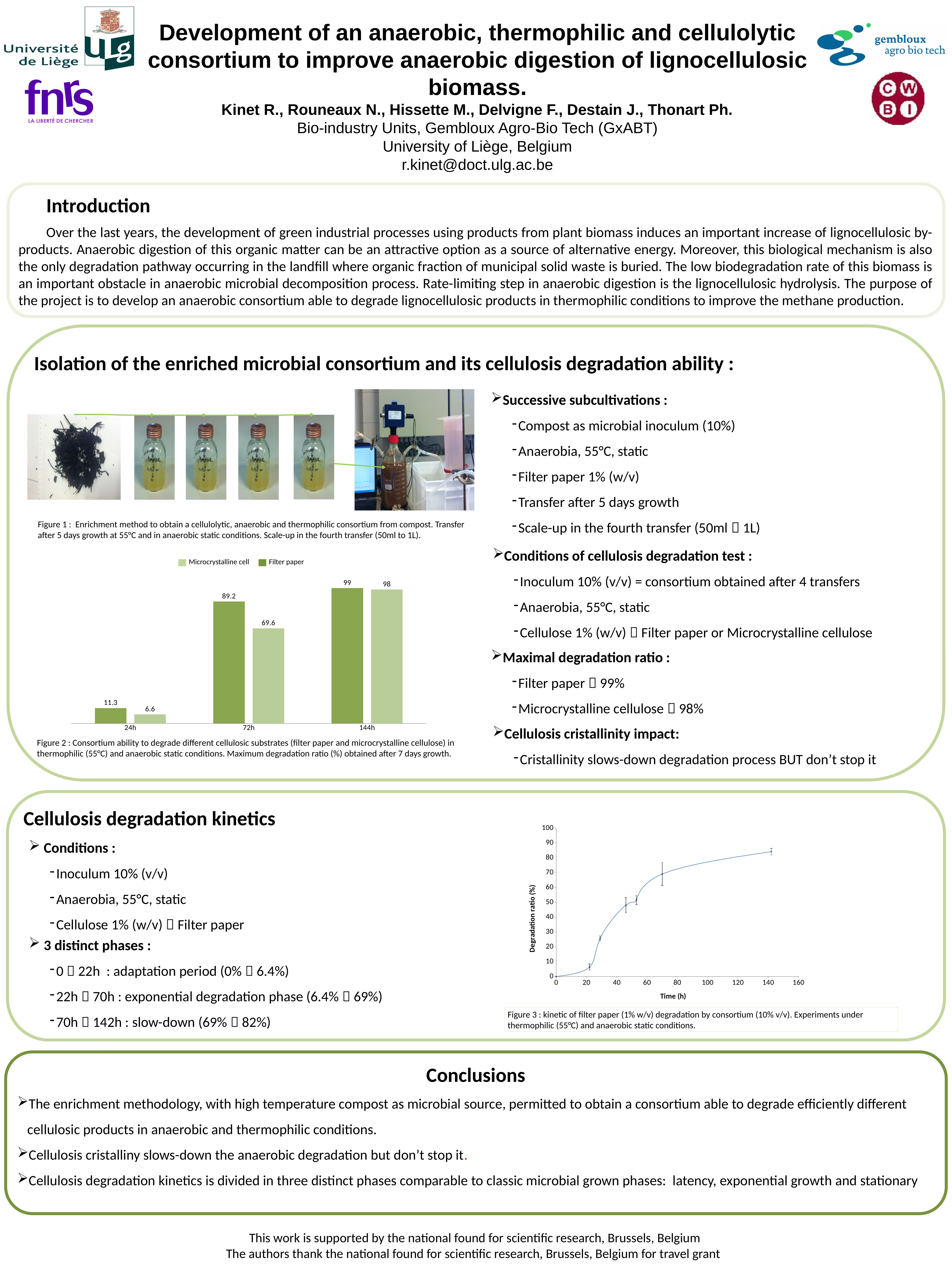
In the Figure 3 line chart, is the degradation ratio at about 140 h greater or less than 80? greater In the Figure 2 bar chart, at which time point is the Microcrystalline cell value lowest? 24h In the Figure 2 bar chart, what is the value for Microcrystalline cell at 144h? 98 In the Figure 3 line chart, does the degradation ratio rise or fall as time increases? rise How many time points are shown on the x axis of the Figure 2 bar chart? 3 In the Figure 2 bar chart, what is the value for Microcrystalline cell at 24h? 6.6 In the Figure 2 bar chart, what is the value for Filter paper at 72h? 89.2 In the Figure 2 bar chart, which is larger at 24h: Filter paper or Microcrystalline cell? Filter paper In the Figure 2 bar chart, what is the difference between Filter paper and Microcrystalline cell at 72h? 19.6 In the Figure 2 bar chart, at which time point is the Filter paper value highest? 144h How many series does the legend of the Figure 2 bar chart list? 2 What kind of chart is Figure 3 (Degradation ratio vs Time)? line chart